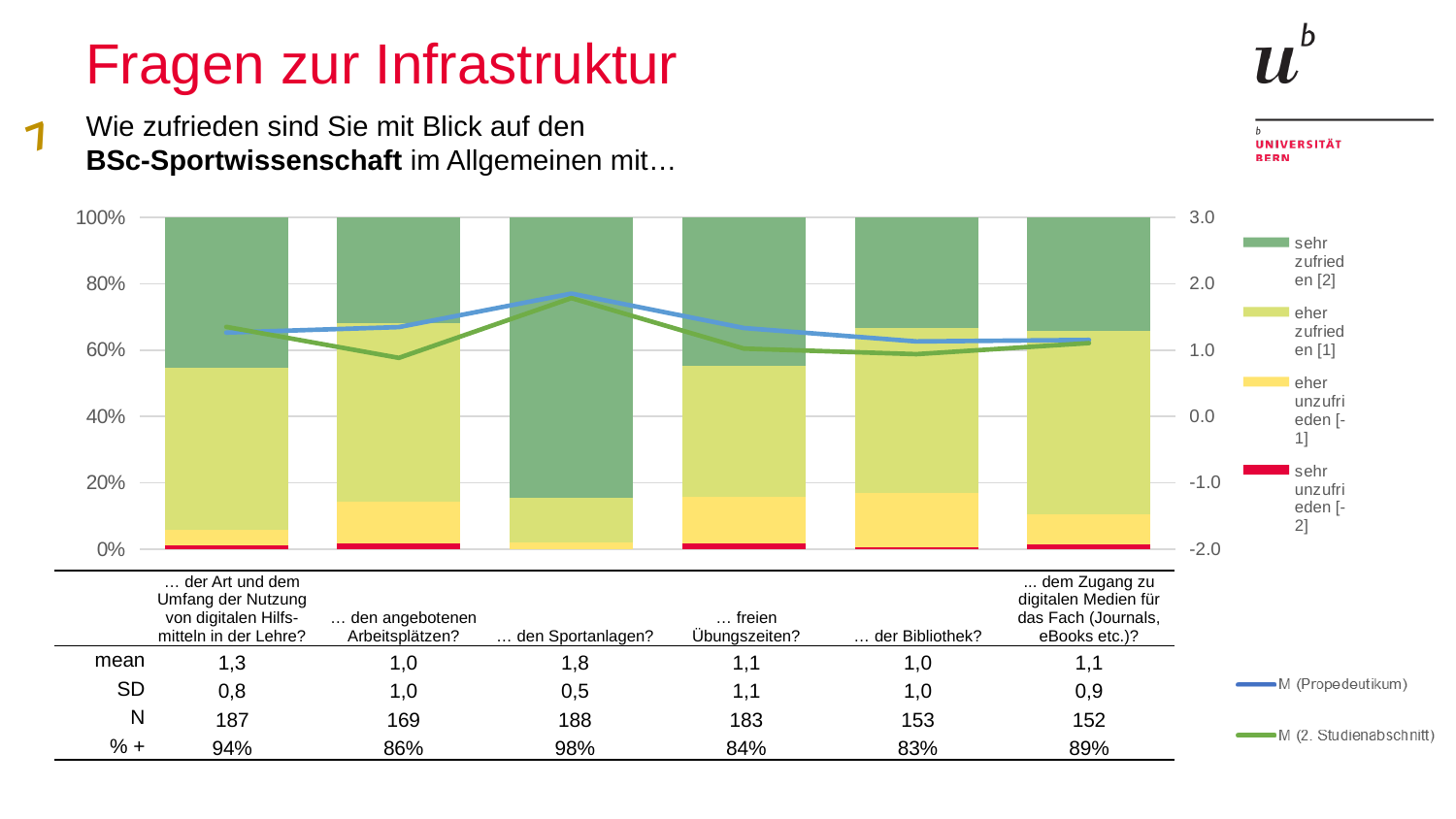
Which has the larger SD: '… den Sportanlagen?' or '… freien Übungszeiten?'? … freien Übungszeiten? How many categories (infrastructure items) are shown along the x axis of the chart? 6 Which category has the lowest '% +' value? … der Bibliothek? Is the M (Propedeutikum) line value for '… den Sportanlagen?' greater or less than 1.0 on the right axis? greater Which series is drawn as the blue line in the chart? M (Propedeutikum) What is the N value shown for '… der Bibliothek?'? 153 How many series does the legend of the chart list in total? 6 What is the '% +' value shown for '… den angebotenen Arbeitsplätzen?'? 86% Which category has the highest mean value in the table below the chart? … den Sportanlagen? What is the mean value shown for '… den Sportanlagen?'? 1,8 What is the difference in N between '… den Sportanlagen?' and '… der Bibliothek?'? 35 What kind of chart is shown on the slide? combination bar and line chart (stacked bars with two lines)